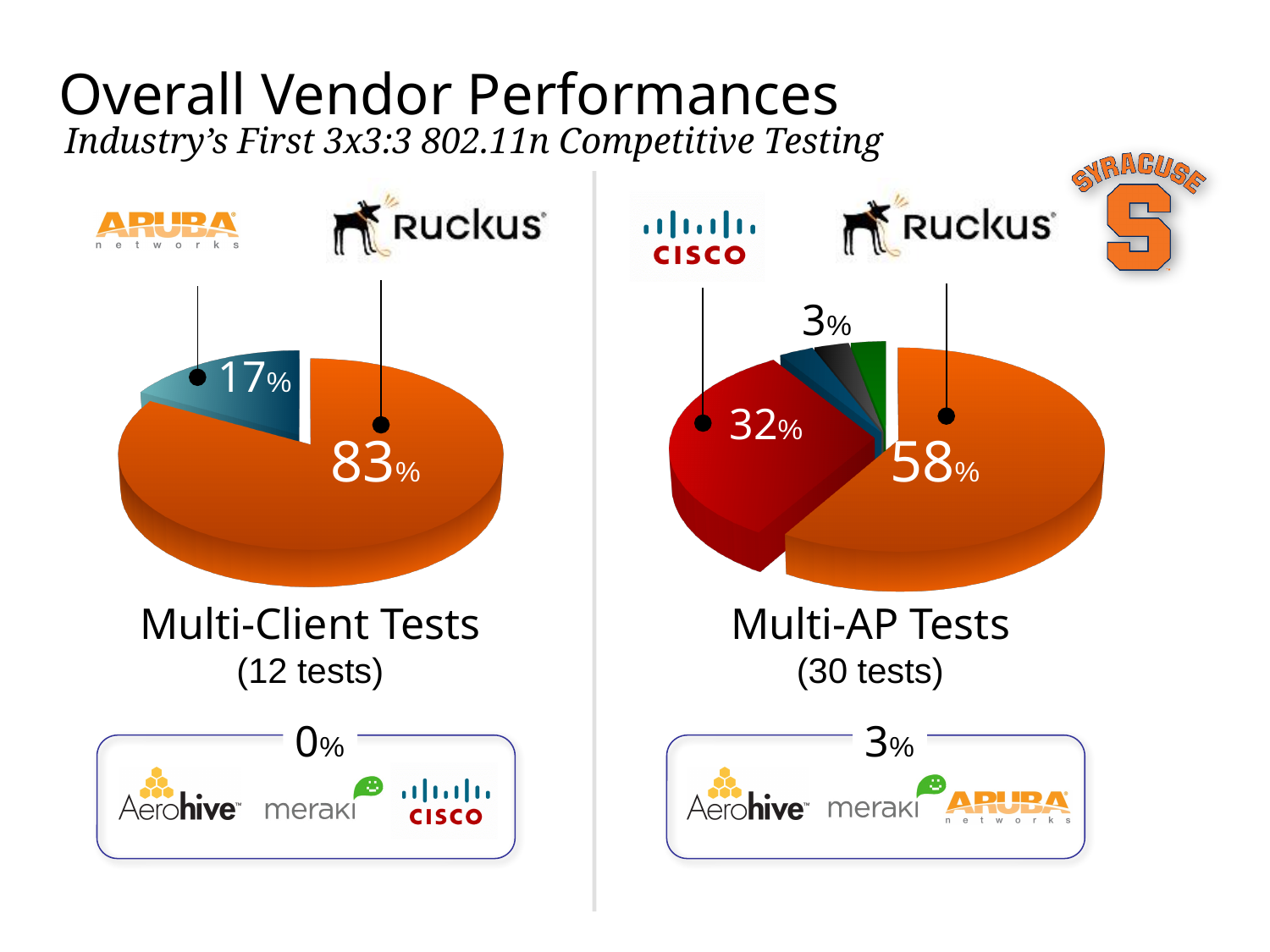
According to the box below the Multi-Client Tests chart, what share did Aerohive, Meraki and Cisco receive? 0% In the Multi-Client Tests pie chart, what share is labelled for Aruba Networks? 17% In the Multi-Client Tests pie chart, which vendor has the largest slice? Ruckus What kind of chart is used for the Multi-Client Tests? Pie chart How many tests does the Multi-AP Tests chart cover, according to the label beneath it? 30 tests In the Multi-AP Tests pie chart, what share is labelled for Ruckus? 58% In the Multi-AP Tests pie chart, what is the difference between the Ruckus share and the Cisco share? 26% In the Multi-Client Tests pie chart, what is the difference between the Ruckus share and the Aruba share? 66% In the Multi-AP Tests pie chart, what share is labelled for Cisco? 32% In the Multi-AP Tests pie chart, which vendor has the largest slice? Ruckus In the Multi-Client Tests pie chart, what share is labelled for Ruckus? 83% In the Multi-AP Tests pie chart, which is larger, the Cisco share or the Ruckus share? Ruckus